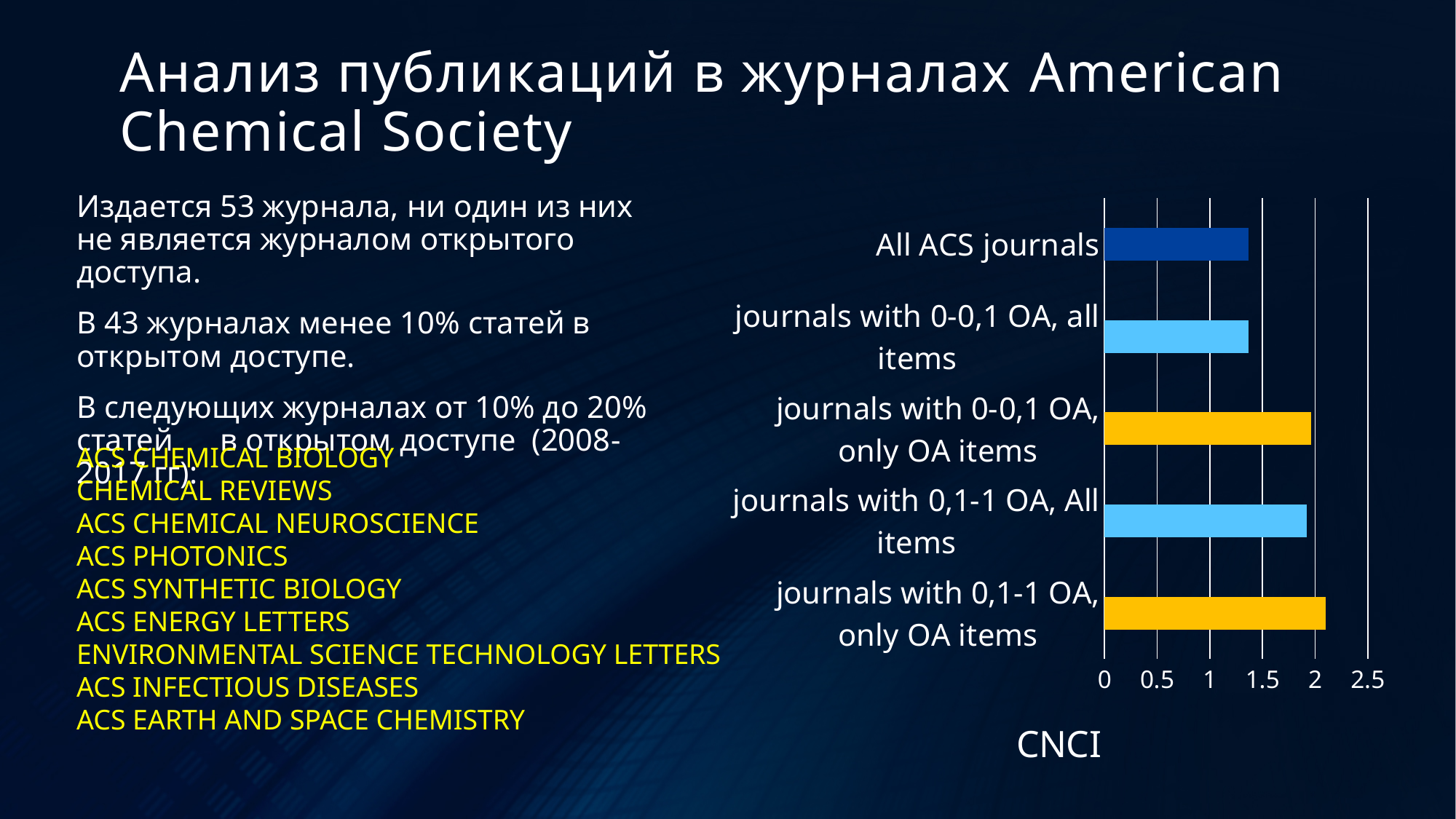
How many categories are plotted in the chart? 5 Is the value for All ACS journals greater or less than 1.5? less Which is larger: the value for journals with 0,1-1 OA, only OA items or the value for journals with 0,1-1 OA, All items? journals with 0,1-1 OA, only OA items Which category has the highest CNCI value in the chart? journals with 0,1-1 OA, only OA items What label is shown beneath the chart's value axis? CNCI Is the value for journals with 0-0,1 OA, only OA items greater or less than 1.5? greater Which is larger: the value for journals with 0-0,1 OA, only OA items or the value for All ACS journals? journals with 0-0,1 OA, only OA items Is the value for journals with 0,1-1 OA, only OA items greater or less than 2? greater What is the highest tick value shown on the chart's value axis? 2.5 What kind of chart is shown on the slide? bar chart